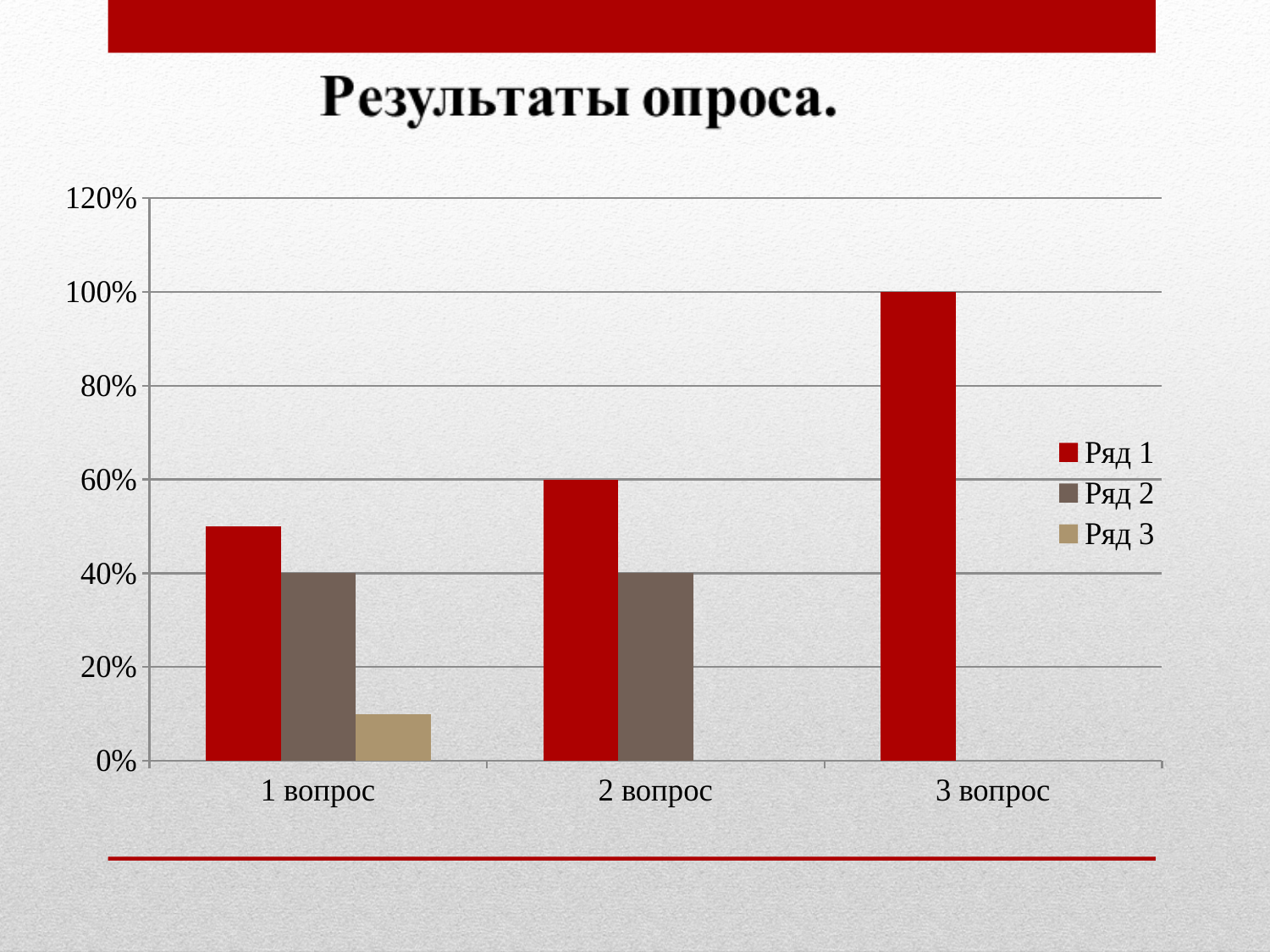
Is the value of Ряд 3 for 1 вопрос greater or less than 20%? less For which category is the Ряд 1 value highest? 3 вопрос What is the title of the chart? Результаты опроса. How many categories are shown on the x axis? 3 How many series does the legend list? 3 For which category is the Ряд 1 value lowest? 1 вопрос What is the value of Ряд 1 for 2 вопрос? 60% What is the value of Ряд 1 for 3 вопрос? 100% What is the value of Ряд 2 for 1 вопрос? 40% Is the value of Ряд 1 for 1 вопрос greater or less than 40%? greater What kind of chart is shown on the slide? bar chart Which is larger for 2 вопрос: Ряд 1 or Ряд 2? Ряд 1